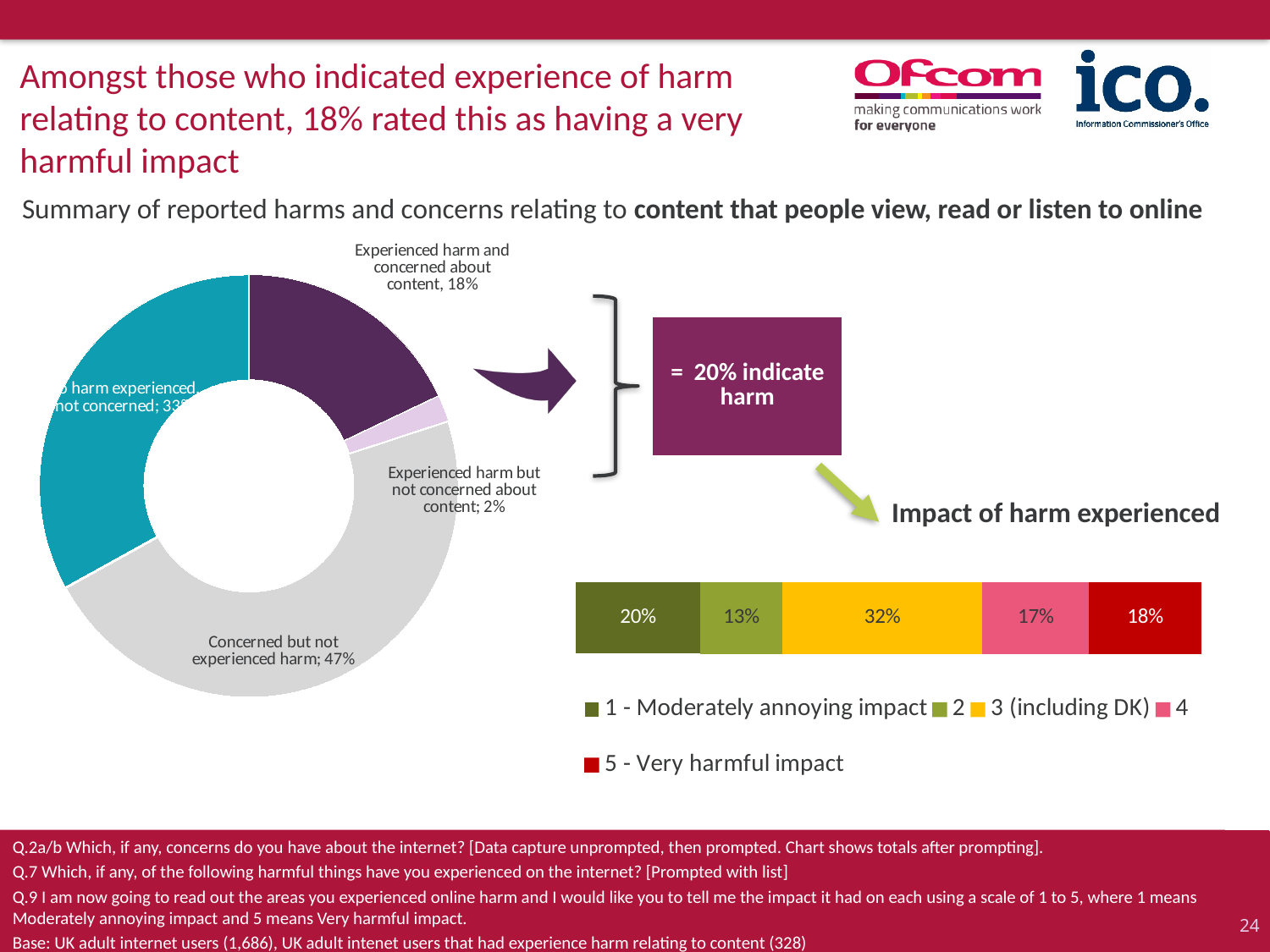
In the 'Impact of harm experienced' bar chart, what percentage is shown for '5 - Very harmful impact'? 18% What type of chart is shown on the left of the slide? Doughnut (pie) chart In the doughnut chart on the left, which category has the smallest share? Experienced harm but not concerned about content In the 'Impact of harm experienced' bar chart, which is larger: the segment for '1 - Moderately annoying impact' or the segment for '2'? 1 - Moderately annoying impact In the 'Impact of harm experienced' bar chart, what percentage is shown for '3 (including DK)'? 32% How many series does the legend of the 'Impact of harm experienced' bar chart list? 5 In the 'Impact of harm experienced' bar chart, which rating has the largest segment? 3 (including DK) In the doughnut chart on the left, what percentage is shown for 'Concerned but not experienced harm'? 47% In the doughnut chart on the left, what percentage is shown for 'Experienced harm but not concerned about content'? 2% In the doughnut chart on the left, what percentage is shown for 'Experienced harm and concerned about content'? 18% In the doughnut chart on the left, which category has the largest share? Concerned but not experienced harm In the doughnut chart on the left, what is the difference in percentage points between 'Concerned but not experienced harm' and 'Experienced harm and concerned about content'? 29 percentage points